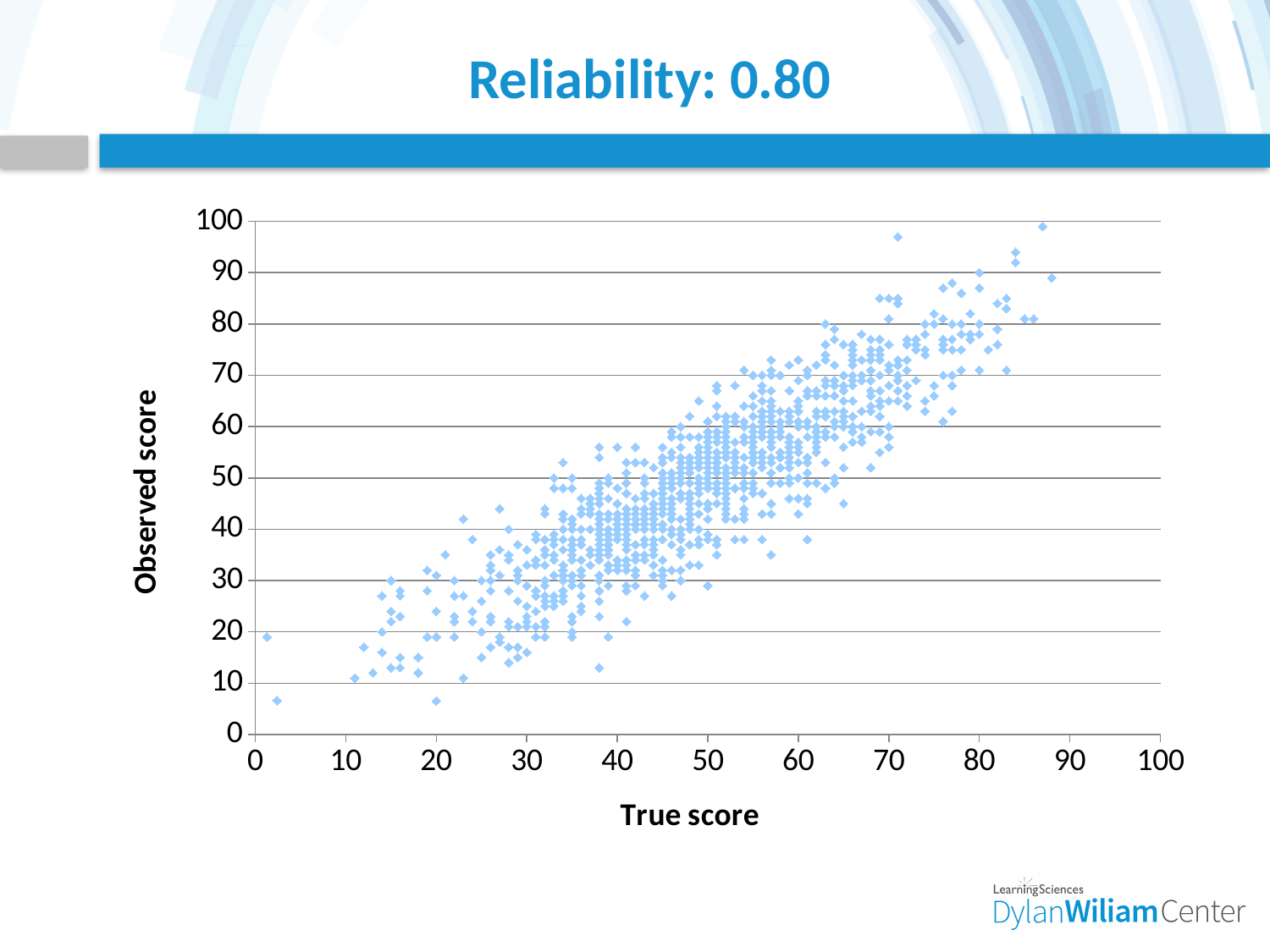
What is the label of the x axis? True score Is the observed score of the lowest point on the chart greater or less than 10? less What is the label of the y axis? Observed score What is the maximum value shown on the y axis? 100 Is the observed score of the highest point on the chart greater or less than 90? greater As the true score increases along the x axis, does the observed score generally rise or fall? rise What is the maximum value shown on the x axis? 100 What kind of chart is shown on the slide? scatter plot What is the interval between consecutive tick marks on the y axis? 10